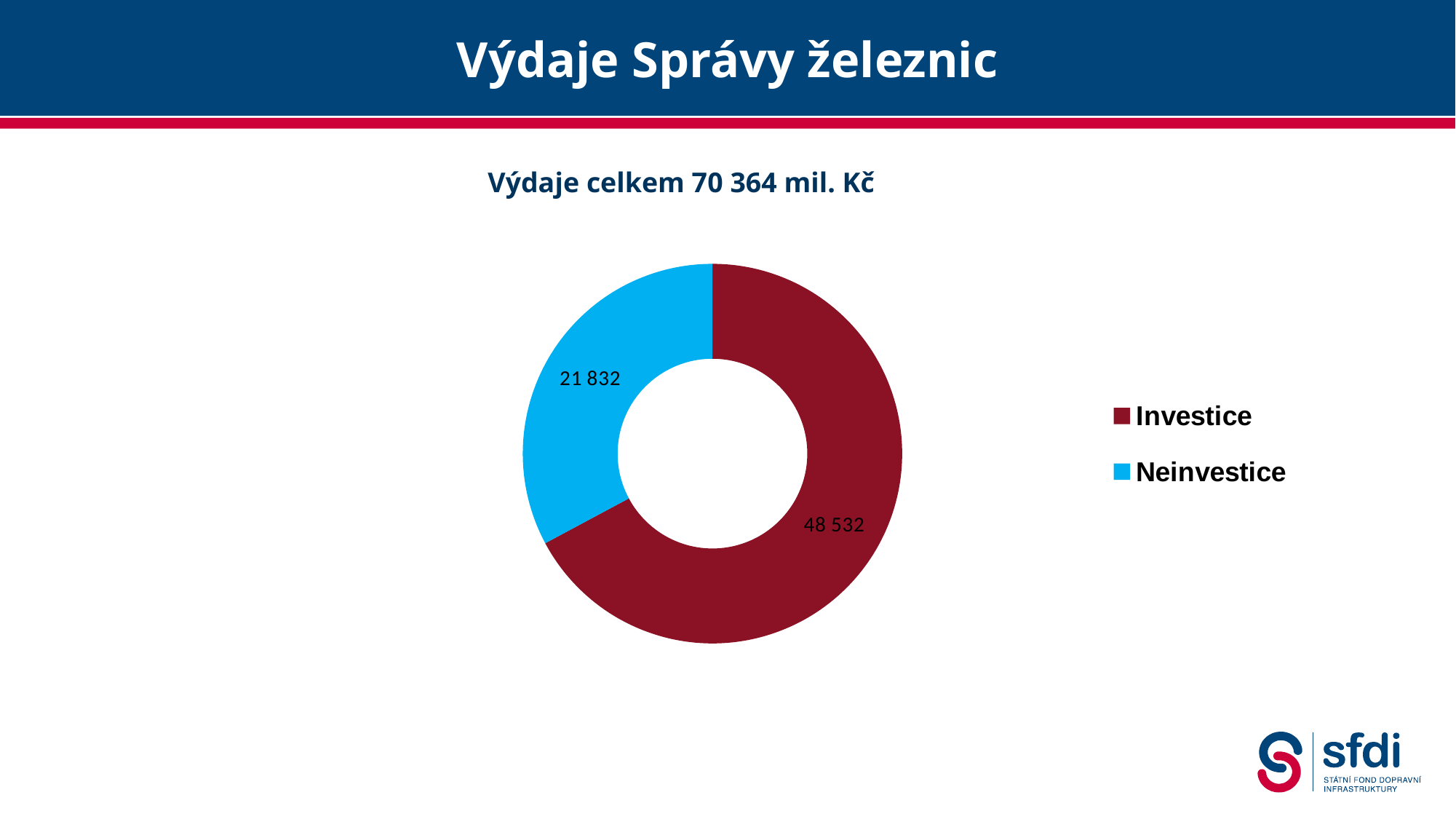
How many slices does the chart have? 2 Which category has the smallest slice? Neinvestice Which is larger, Investice or Neinvestice? Investice What is the value of the Investice slice? 48 532 What kind of chart is shown on the slide? Doughnut (pie) chart What is the chart's title? Výdaje celkem 70 364 mil. Kč What is the difference between the Investice and Neinvestice values? 26 700 What is the value of the Neinvestice slice? 21 832 Which category has the largest slice? Investice What is the total of the two slices shown in the chart? 70 364 To the nearest whole percent, what share of the total does Investice represent? 69% What colour is the Neinvestice slice? Light blue